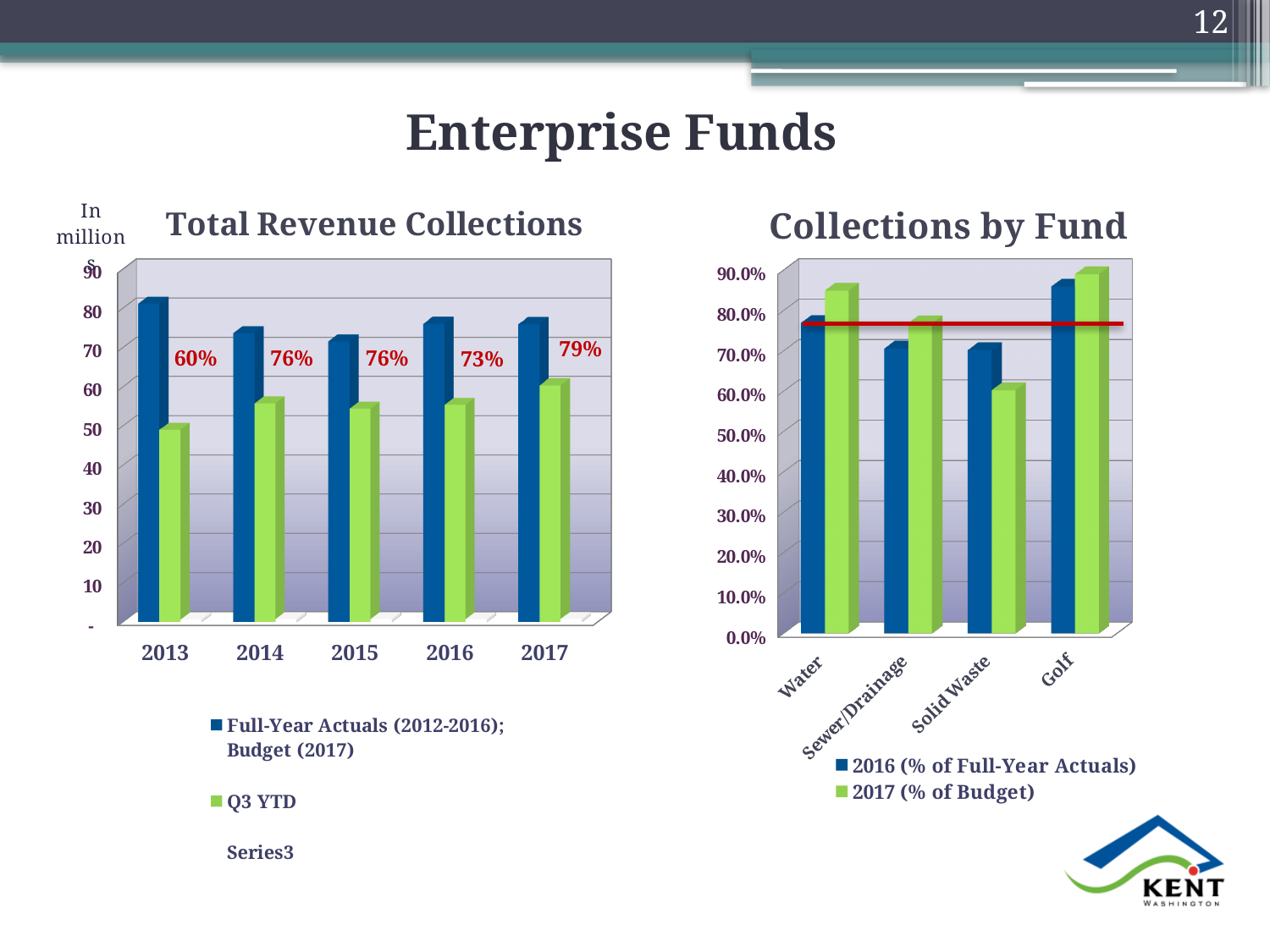
In the Collections by Fund chart, how many series does the legend list? 2 In the Total Revenue Collections chart, what percentage label is shown for 2013? 60% In the Total Revenue Collections chart, what percentage label is shown for 2017? 79% In the Collections by Fund chart, how many funds are shown on the x axis? 4 In the Total Revenue Collections chart, how many percentage points higher is the 2017 label than the 2013 label? 19 percentage points In the Collections by Fund chart, is the 2016 (% of Full-Year Actuals) value for Golf greater or less than 80.0%? greater In the Total Revenue Collections chart, which year has the highest percentage label? 2017 In the Collections by Fund chart, which fund has the lowest 2017 (% of Budget) value? Solid Waste What kind of chart is the Collections by Fund chart? bar chart In the Total Revenue Collections chart, which year has the lowest percentage label? 2013 In the Total Revenue Collections chart, how many years are shown on the x axis? 5 In the Total Revenue Collections chart, is the Q3 YTD value for 2013 greater or less than 60? less